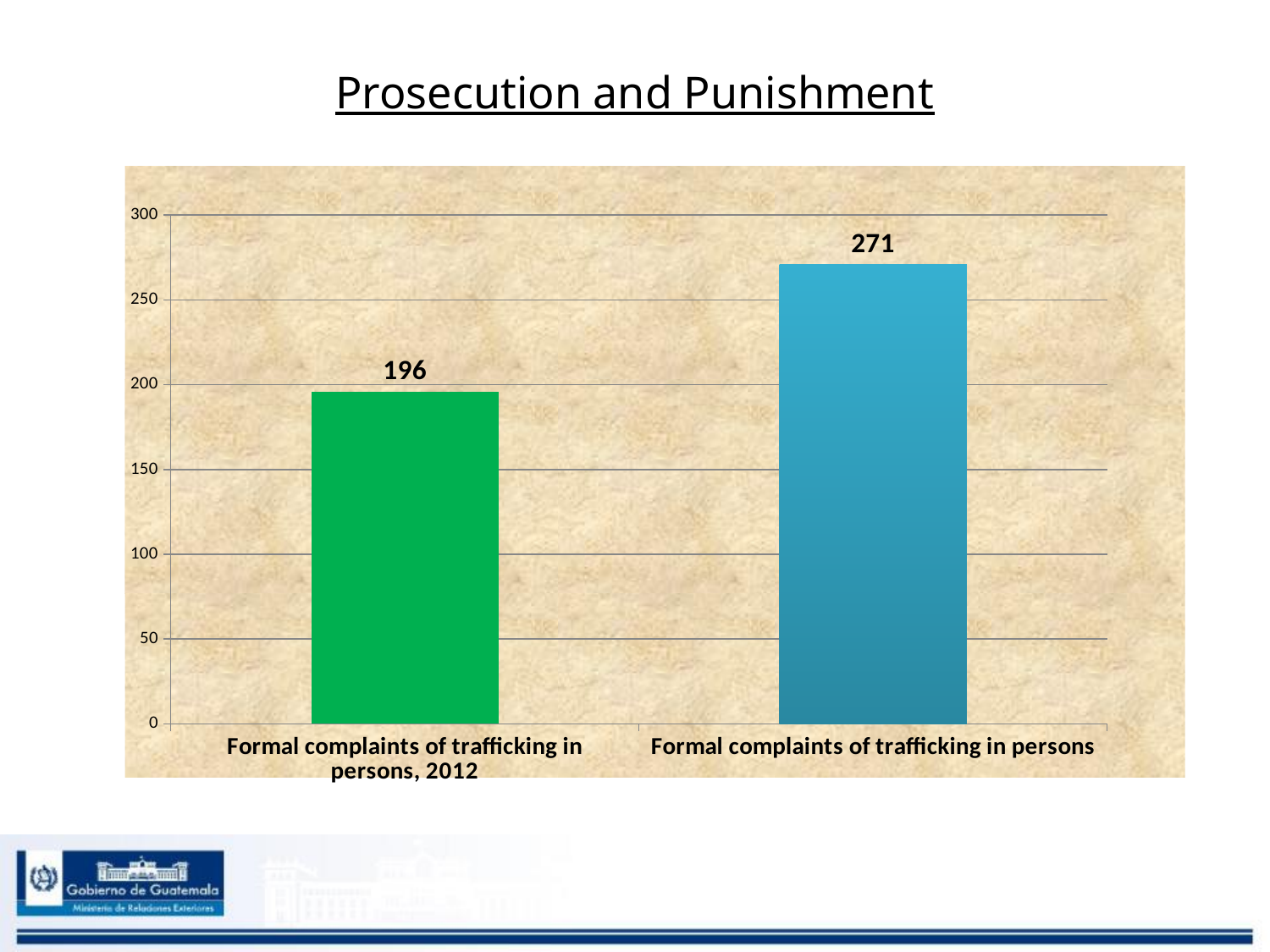
Is the value for "Formal complaints of trafficking in persons" greater or less than 250? greater What is the value for "Formal complaints of trafficking in persons" (the right-hand bar)? 271 Is the value for "Formal complaints of trafficking in persons, 2012" greater or less than 200? less How many bars are shown in the chart? 2 Which is larger: the value for "Formal complaints of trafficking in persons, 2012" or the value for "Formal complaints of trafficking in persons"? Formal complaints of trafficking in persons Which category has the lowest value? Formal complaints of trafficking in persons, 2012 Which category has the highest value? Formal complaints of trafficking in persons What kind of chart is shown on the slide? Bar chart What is the value for "Formal complaints of trafficking in persons, 2012"? 196 What is the title of the slide? Prosecution and Punishment What is the difference between the two bars' values? 75 What colour is the bar for "Formal complaints of trafficking in persons, 2012"? Green